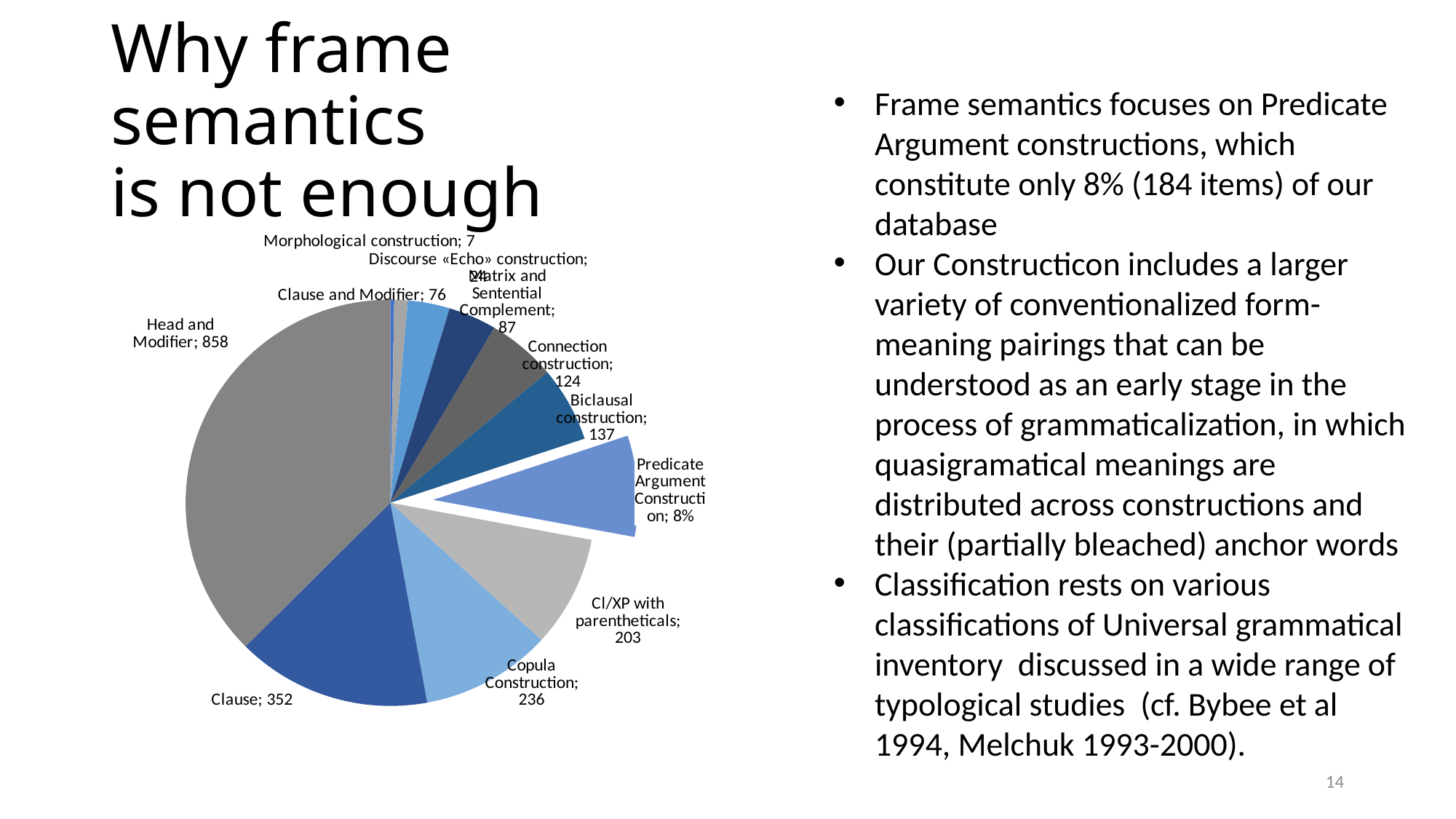
What is the value for Connection construction in the pie chart? 124 What is the value for Biclausal construction in the pie chart? 137 What is the value for Clause in the pie chart? 352 Which category has the largest slice in the pie chart? Head and Modifier What is the value for Copula Construction in the pie chart? 236 Which category has the smallest slice in the pie chart? Morphological construction What is the value for Cl/XP with parentheticals in the pie chart? 203 What is the difference between the values for Clause and Copula Construction? 116 What share of the pie does Predicate Argument Construction represent? 8% What is the value for Head and Modifier in the pie chart? 858 What type of chart is shown on the slide? pie chart Which is larger, Biclausal construction or Connection construction? Biclausal construction